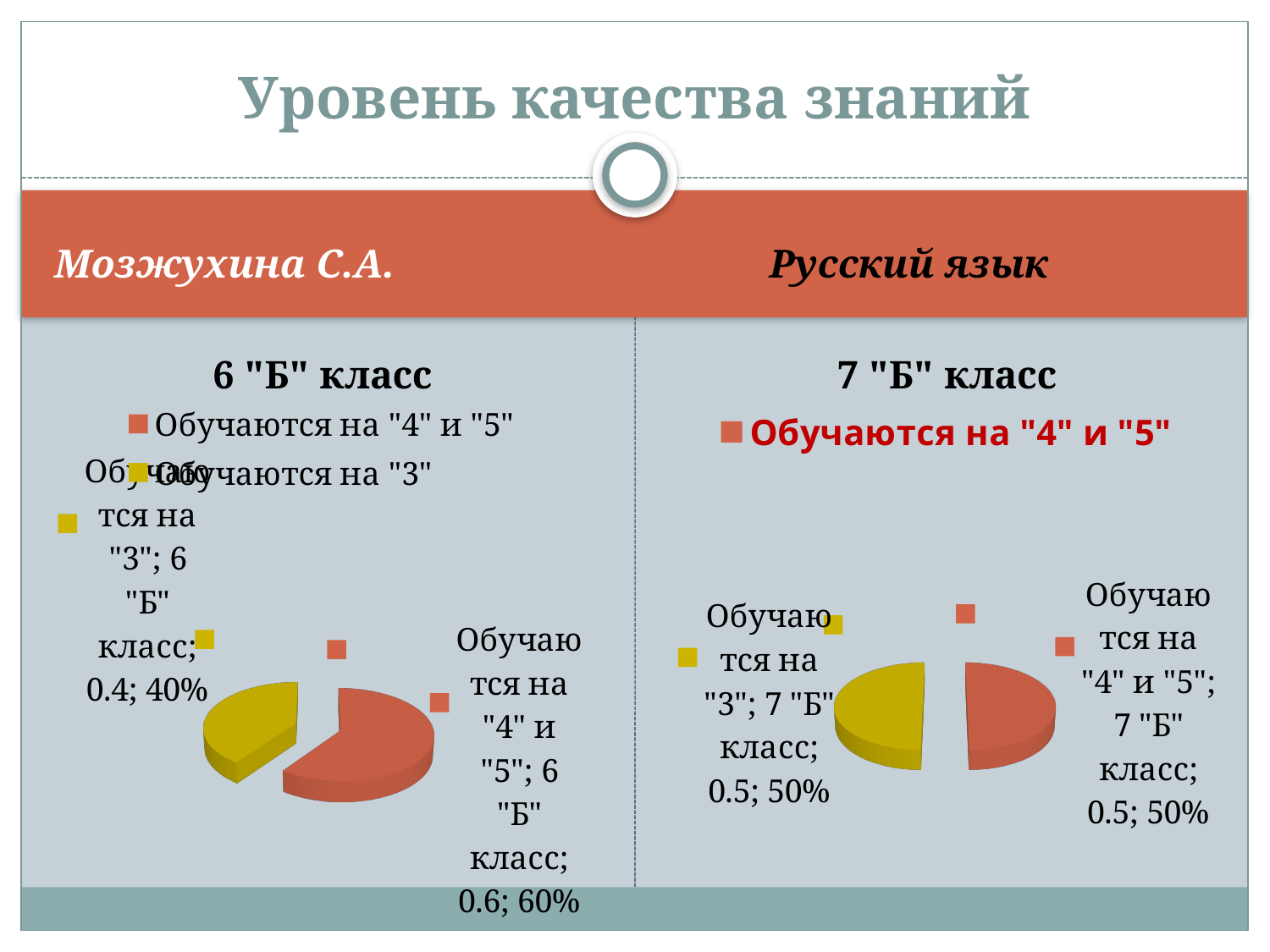
In the 6 "Б" класс chart, what share of the pie is labelled Обучаются на "4" и "5"? 60% In the 6 "Б" класс chart, what value is printed for Обучаются на "4" и "5"? 0.6 What is the title of the chart on the right side of the slide? 7 "Б" класс In the 7 "Б" класс chart, what share of the pie is labelled Обучаются на "3"? 50% How many entries does the legend of the 6 "Б" класс chart list? 2 How many slices does the 6 "Б" класс pie chart have? 2 In the 6 "Б" класс chart, what share of the pie is labelled Обучаются на "3"? 40% In the 6 "Б" класс chart, what is the difference in percentage points between the Обучаются на "4" и "5" slice and the Обучаются на "3" slice? 20% What type of chart is used for the 6 "Б" класс chart? pie chart In the 6 "Б" класс chart, which category has the largest slice? Обучаются на "4" и "5" In the 7 "Б" класс chart, what value is printed for Обучаются на "4" и "5"? 0.5 In the 6 "Б" класс chart, which category has the smallest slice? Обучаются на "3"